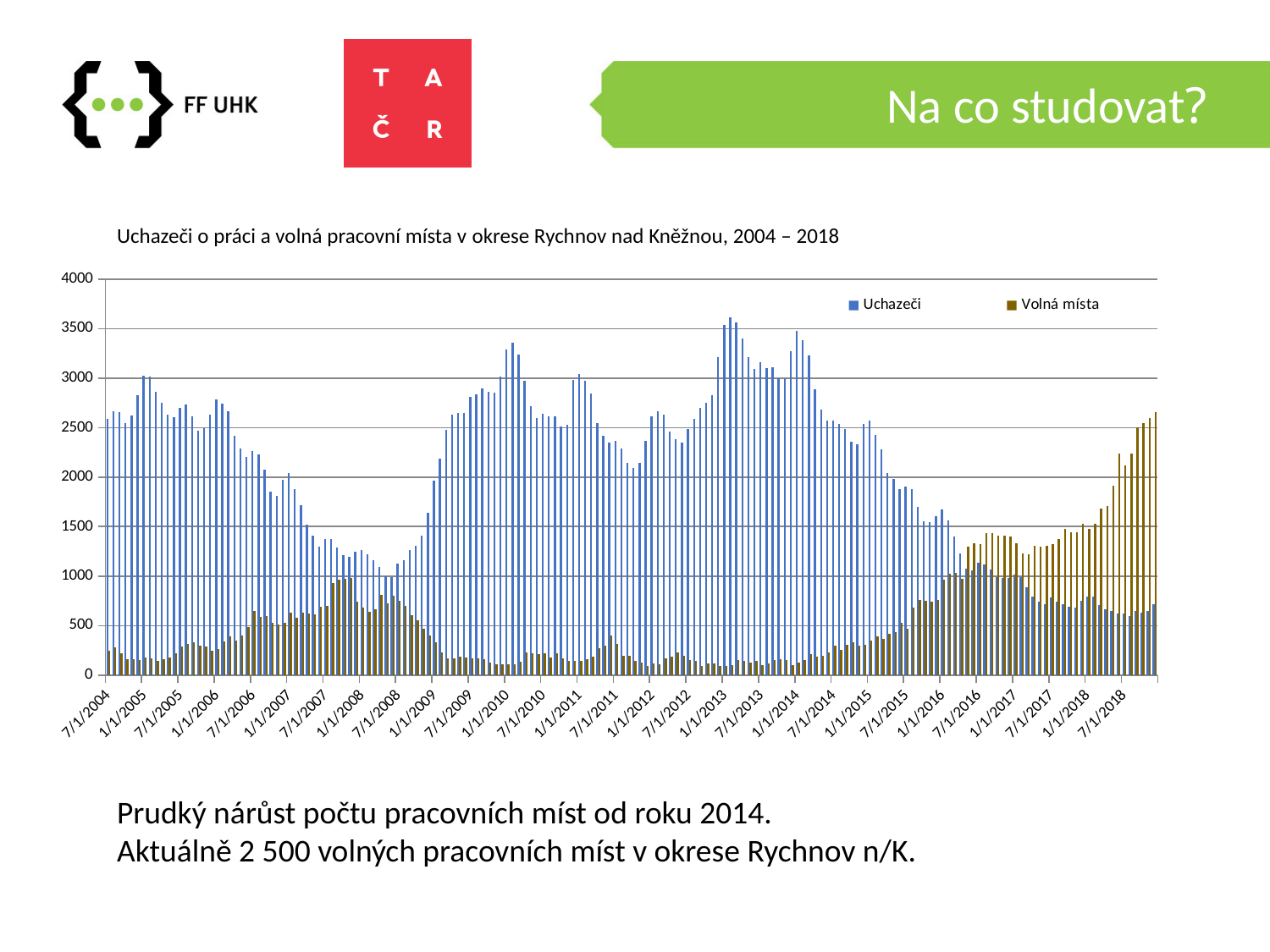
Is the value of Volná místa at 7/1/2018 greater or less than 2000? greater Is the value of Volná místa at 1/1/2013 greater or less than 500? less At 1/1/2010, which series has the larger value, Uchazeči or Volná místa? Uchazeči How many series does the chart legend list? 2 Do the values of Volná místa rise or fall from 1/1/2017 to the end of the chart? rise What is the title of the chart? Uchazeči o práci a volná pracovní místa v okrese Rychnov nad Kněžnou, 2004 – 2018 Which series is drawn in blue in the chart? Uchazeči Is the value of Uchazeči at 1/1/2008 greater or less than 1500? less Do the values of Uchazeči rise or fall from 1/1/2013 to 1/1/2016? fall At 7/1/2018, which series has the larger value, Uchazeči or Volná místa? Volná místa What kind of chart is shown on the slide? bar chart